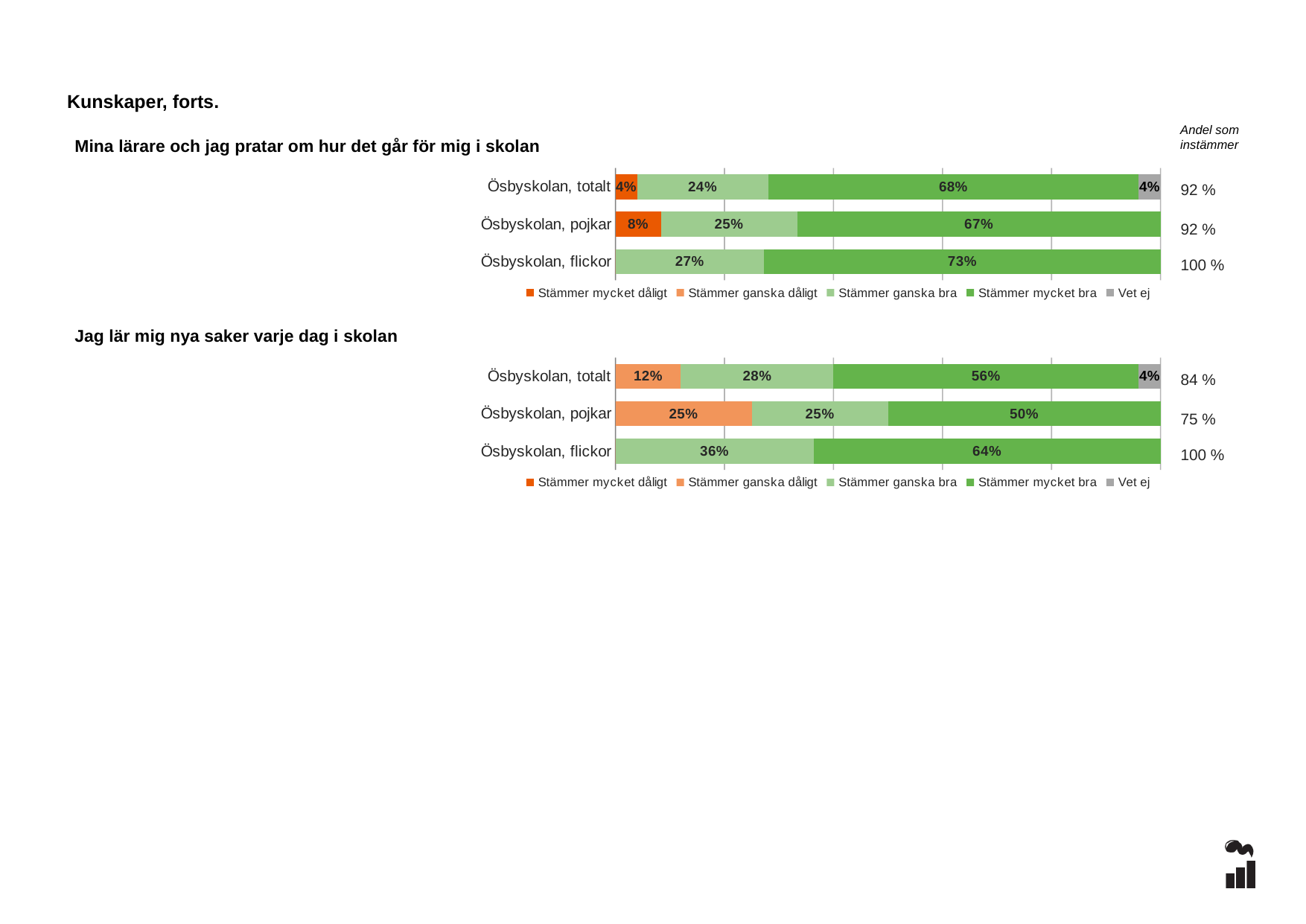
In the chart 'Jag lär mig nya saker varje dag i skolan', what is the value for 'Stämmer ganska bra' for Ösbyskolan, flickor? 36% How many series does the legend of the chart 'Jag lär mig nya saker varje dag i skolan' list? 5 In the chart 'Jag lär mig nya saker varje dag i skolan', what is the 'Andel som instämmer' for Ösbyskolan, pojkar? 75 % In the chart 'Mina lärare och jag pratar om hur det går för mig i skolan', what is the value for 'Stämmer mycket dåligt' for Ösbyskolan, pojkar? 8% In the chart 'Jag lär mig nya saker varje dag i skolan', is 'Stämmer mycket bra' larger for Ösbyskolan, totalt or Ösbyskolan, flickor? Ösbyskolan, flickor In the chart 'Mina lärare och jag pratar om hur det går för mig i skolan', what is the difference between 'Stämmer mycket bra' for Ösbyskolan, flickor and Ösbyskolan, pojkar? 6% What kind of chart is 'Mina lärare och jag pratar om hur det går för mig i skolan'? Stacked bar chart In the chart 'Jag lär mig nya saker varje dag i skolan', what is the value for 'Stämmer ganska dåligt' for Ösbyskolan, pojkar? 25% How many categories are shown in the chart 'Mina lärare och jag pratar om hur det går för mig i skolan'? 3 In the chart 'Mina lärare och jag pratar om hur det går för mig i skolan', what is the value for 'Stämmer mycket bra' for Ösbyskolan, totalt? 68% In the chart 'Jag lär mig nya saker varje dag i skolan', which category has the lowest value for 'Stämmer mycket bra'? Ösbyskolan, pojkar In the chart 'Mina lärare och jag pratar om hur det går för mig i skolan', which category has the highest value for 'Stämmer mycket bra'? Ösbyskolan, flickor